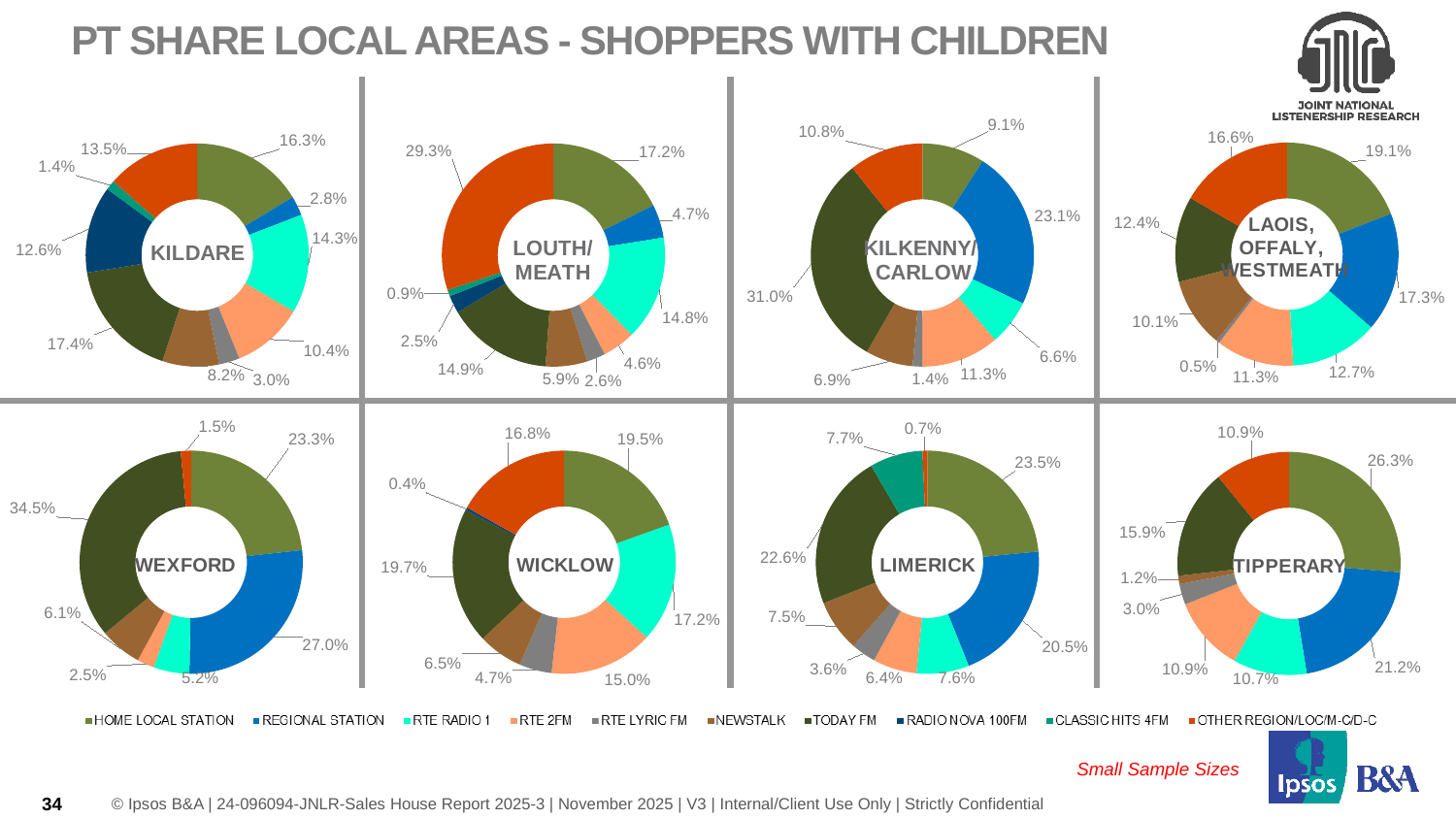
How many series does the legend at the bottom of the slide list? 10 In the KILDARE chart, what share is shown for Today FM? 17.4% In the TIPPERARY chart, what share is shown for Home Local Station? 26.3% In the KILKENNY/CARLOW chart, which station has the largest share? Today FM (31.0%) What kind of chart is used for each local area on this slide? Donut (pie) chart In the LOUTH/MEATH chart, what share is shown for Other Region/Loc/M-C/D-C? 29.3% In the LIMERICK chart, which station has the smallest share? Other Region/Loc/M-C/D-C (0.7%) How many segments does the KILDARE donut chart have? 10 In the KILDARE chart, what is the difference between the Today FM share and the Radio Nova 100FM share? 4.8 percentage points What is the title of the slide? PT SHARE LOCAL AREAS - SHOPPERS WITH CHILDREN In the WEXFORD chart, which station has the largest share? Today FM (34.5%) In the WEXFORD chart, which is larger: the Regional Station share or the Home Local Station share? Regional Station (27.0%)